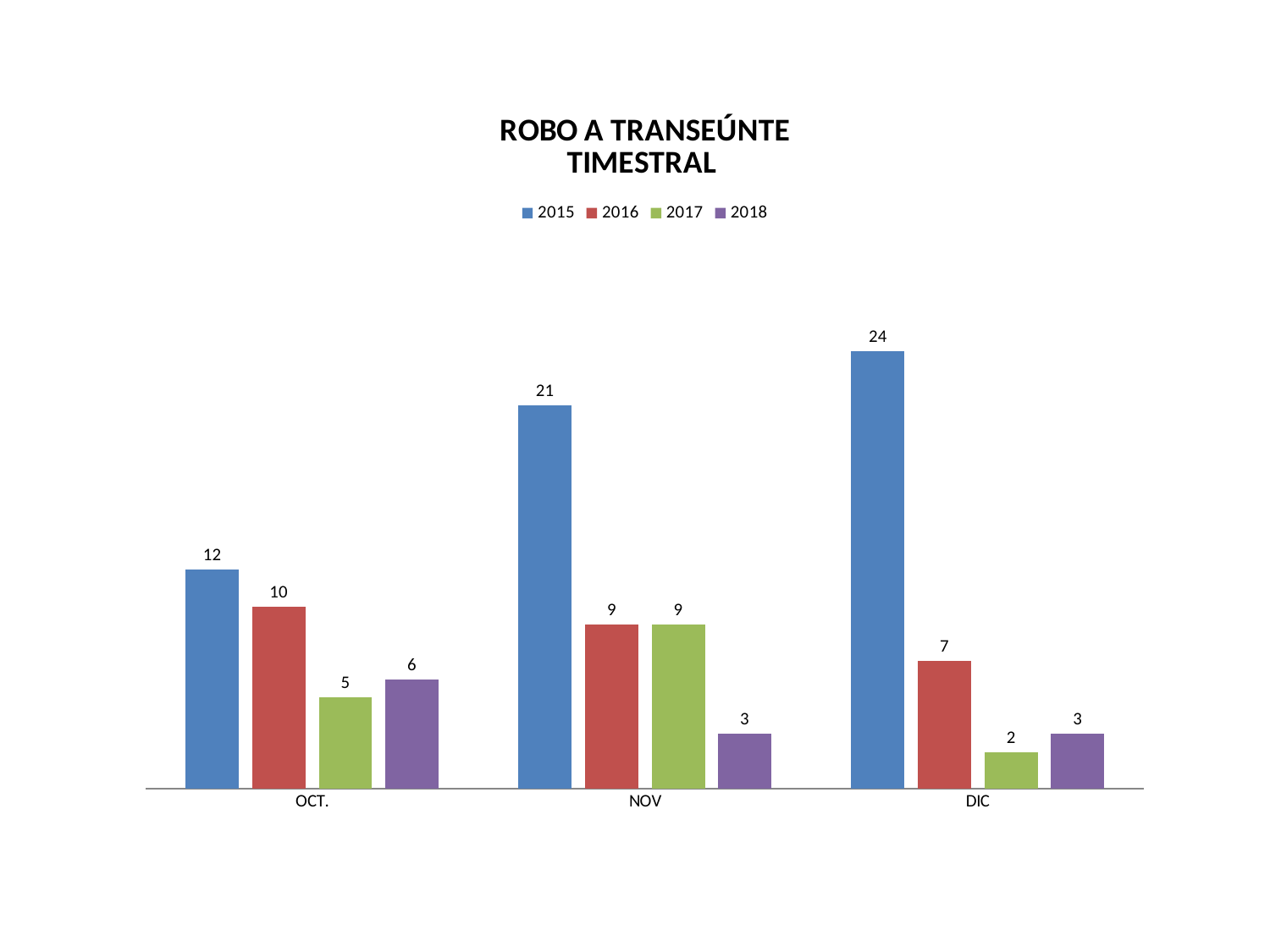
What is the value for 2015 in NOV? 21 How many months are shown on the x axis? 3 Which is larger in OCT., the 2017 value or the 2018 value? 2018 What is the value for 2017 in OCT.? 5 What is the value for 2018 in DIC? 3 How many series does the legend list? 4 What kind of chart is shown? bar chart What is the difference between the 2015 and 2016 values in DIC? 17 In which month is the 2017 value lowest? DIC In which month is the 2015 value highest? DIC Does the 2015 series rise or fall from OCT. to DIC? rise What is the title of the chart? ROBO A TRANSEÚNTE TIMESTRAL